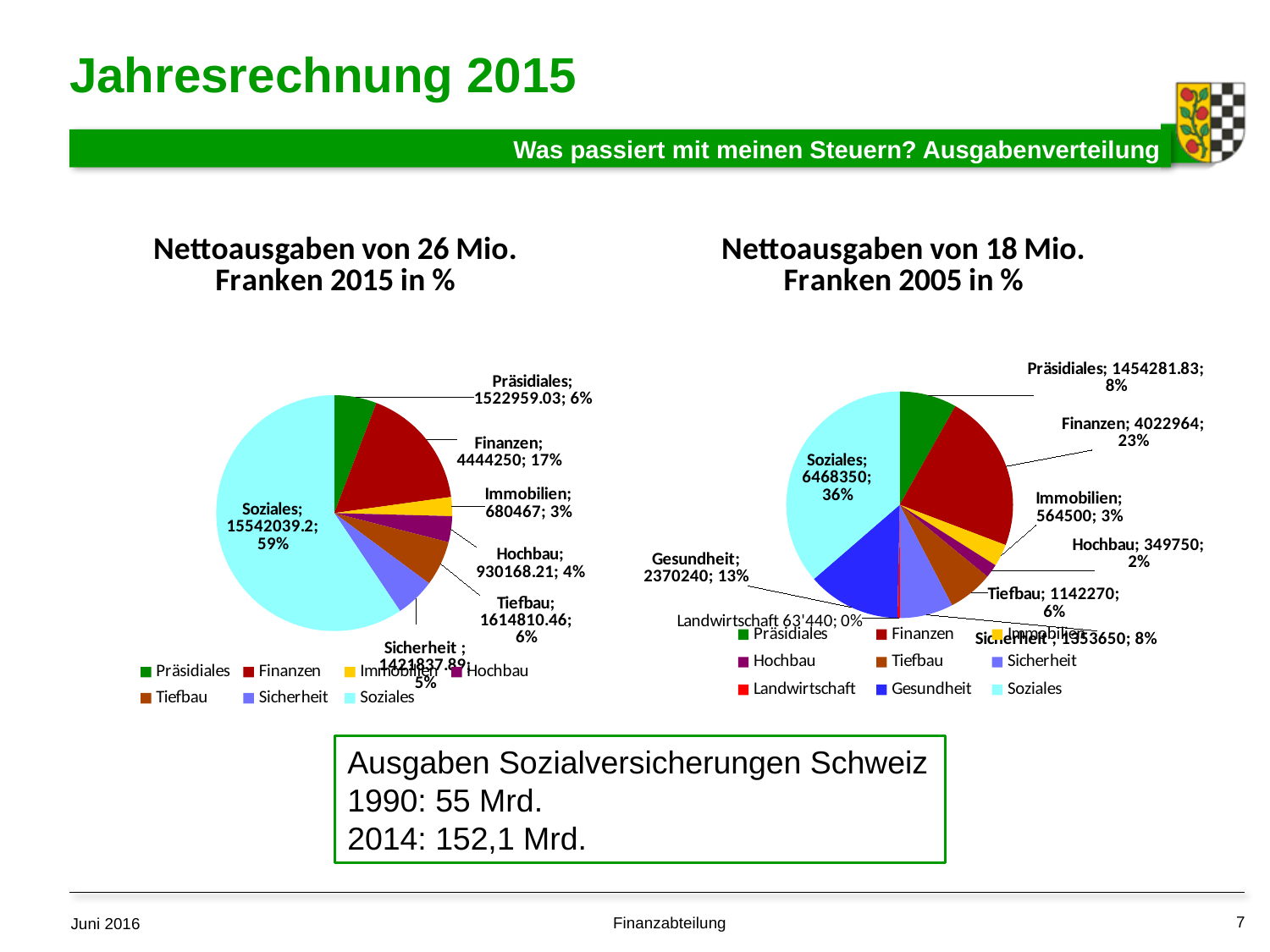
In the chart 'Nettoausgaben von 18 Mio. Franken 2005 in %', what percentage share does Landwirtschaft have? 0% In the chart 'Nettoausgaben von 18 Mio. Franken 2005 in %', which category has the largest share? Soziales In the chart 'Nettoausgaben von 26 Mio. Franken 2015 in %', how many categories does the legend list? 7 In the chart 'Nettoausgaben von 18 Mio. Franken 2005 in %', what is the difference in percentage points between Soziales and Finanzen? 13 percentage points What type of chart is used on this slide for the 2015 and 2005 expenditure breakdowns? Pie chart Which chart shows a larger percentage share for Soziales: the 2015 chart or the 2005 chart? The 2015 chart In the chart 'Nettoausgaben von 18 Mio. Franken 2005 in %', what is the value shown for Finanzen? 4022964 In the chart 'Nettoausgaben von 26 Mio. Franken 2015 in %', which category has the smallest share? Immobilien In the chart 'Nettoausgaben von 18 Mio. Franken 2005 in %', what percentage share does Gesundheit have? 13% In the chart 'Nettoausgaben von 26 Mio. Franken 2015 in %', what is the value shown for Finanzen? 4444250 In the chart 'Nettoausgaben von 18 Mio. Franken 2005 in %', how many categories does the legend list? 9 In the chart 'Nettoausgaben von 26 Mio. Franken 2015 in %', what percentage share does Soziales have? 59%